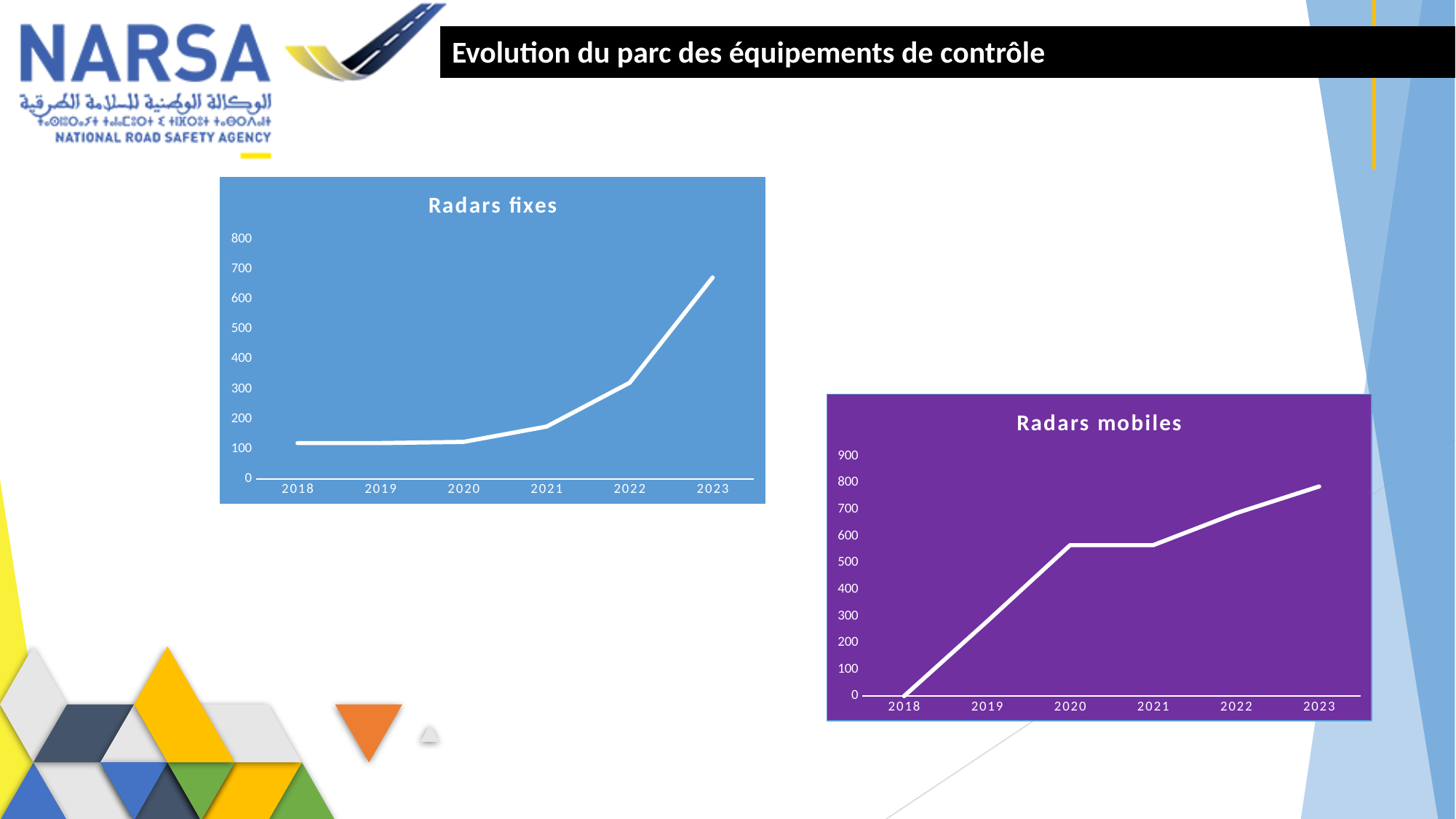
In the "Radars mobiles" chart, is the value for 2019 greater or less than 400? less In the "Radars fixes" chart, how many years are shown on the x axis? 6 In the "Radars mobiles" chart, how many years are shown on the x axis? 6 In the "Radars fixes" chart, is the value for 2018 greater or less than 200? less In the "Radars fixes" chart, do the values rise or fall from 2018 to 2023? rise What type of chart is the "Radars mobiles" chart? line chart What type of chart is the "Radars fixes" chart? line chart In the "Radars fixes" chart, which year has the highest value? 2023 In the "Radars mobiles" chart, which is larger, the value for 2020 or the value for 2019? 2020 In the "Radars fixes" chart, is the value for 2023 greater or less than 600? greater In the "Radars mobiles" chart, which year has the lowest value? 2018